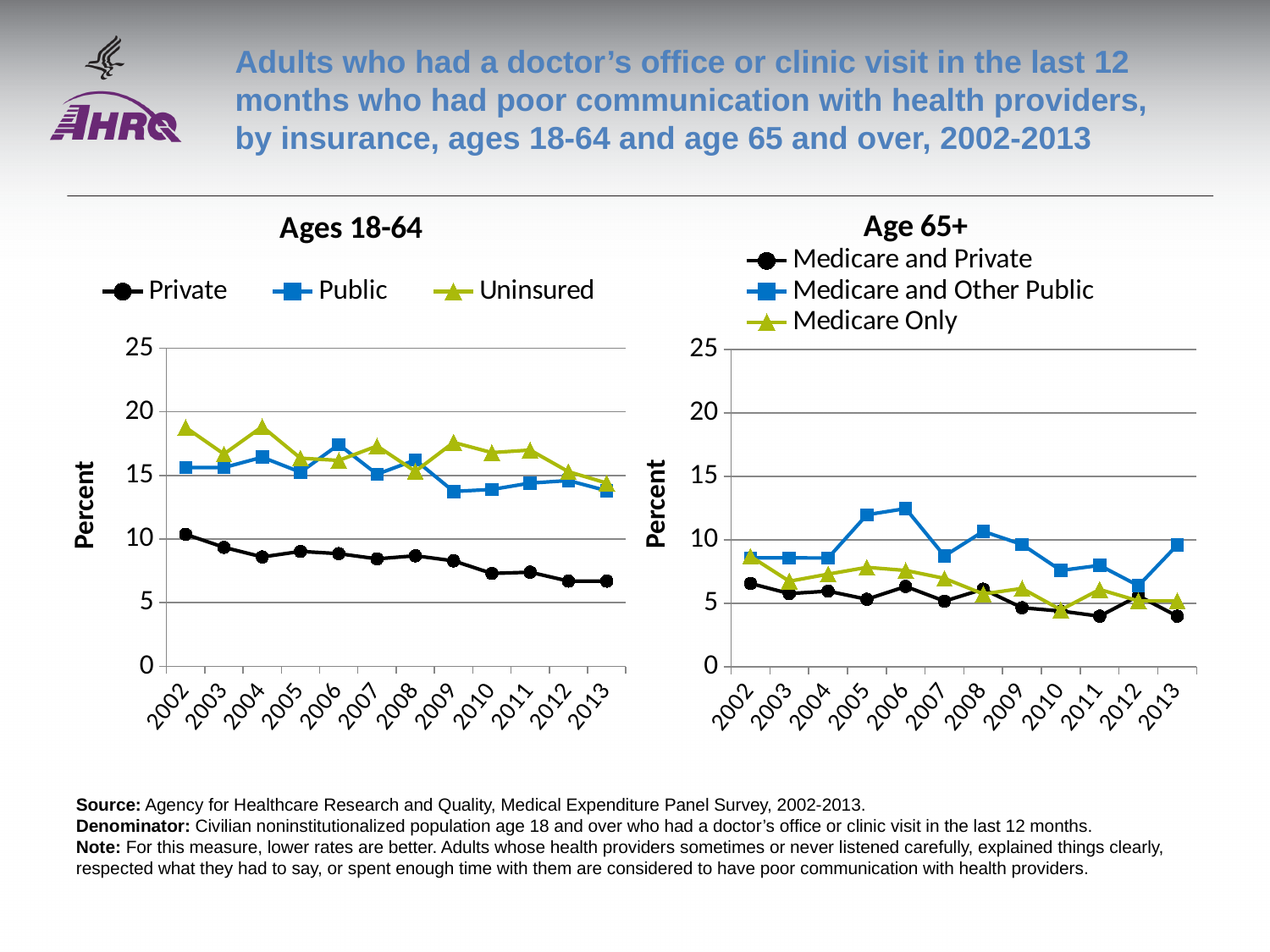
In the "Ages 18-64" chart, is the value for Uninsured in 2002 greater or less than 15? greater How many series does the legend of the "Ages 18-64" chart list? 3 In the "Ages 18-64" chart, does the Private line generally rise or fall from 2002 to 2013? Fall What is the label on the y axis of the "Age 65+" chart? Percent In the "Age 65+" chart, is the value for Medicare and Other Public in 2006 greater or less than 10? greater In the "Ages 18-64" chart, is the value for Private in 2013 greater or less than 10? less What kind of chart is the "Ages 18-64" chart? Line chart How many years are shown on the x axis of the "Ages 18-64" chart? 12 In the "Ages 18-64" chart, which series has the lowest value in 2013? Private In the "Ages 18-64" chart, which is larger in 2002: Private or Uninsured? Uninsured How many series does the legend of the "Age 65+" chart list? 3 In the "Age 65+" chart, which series has the highest value in 2006? Medicare and Other Public